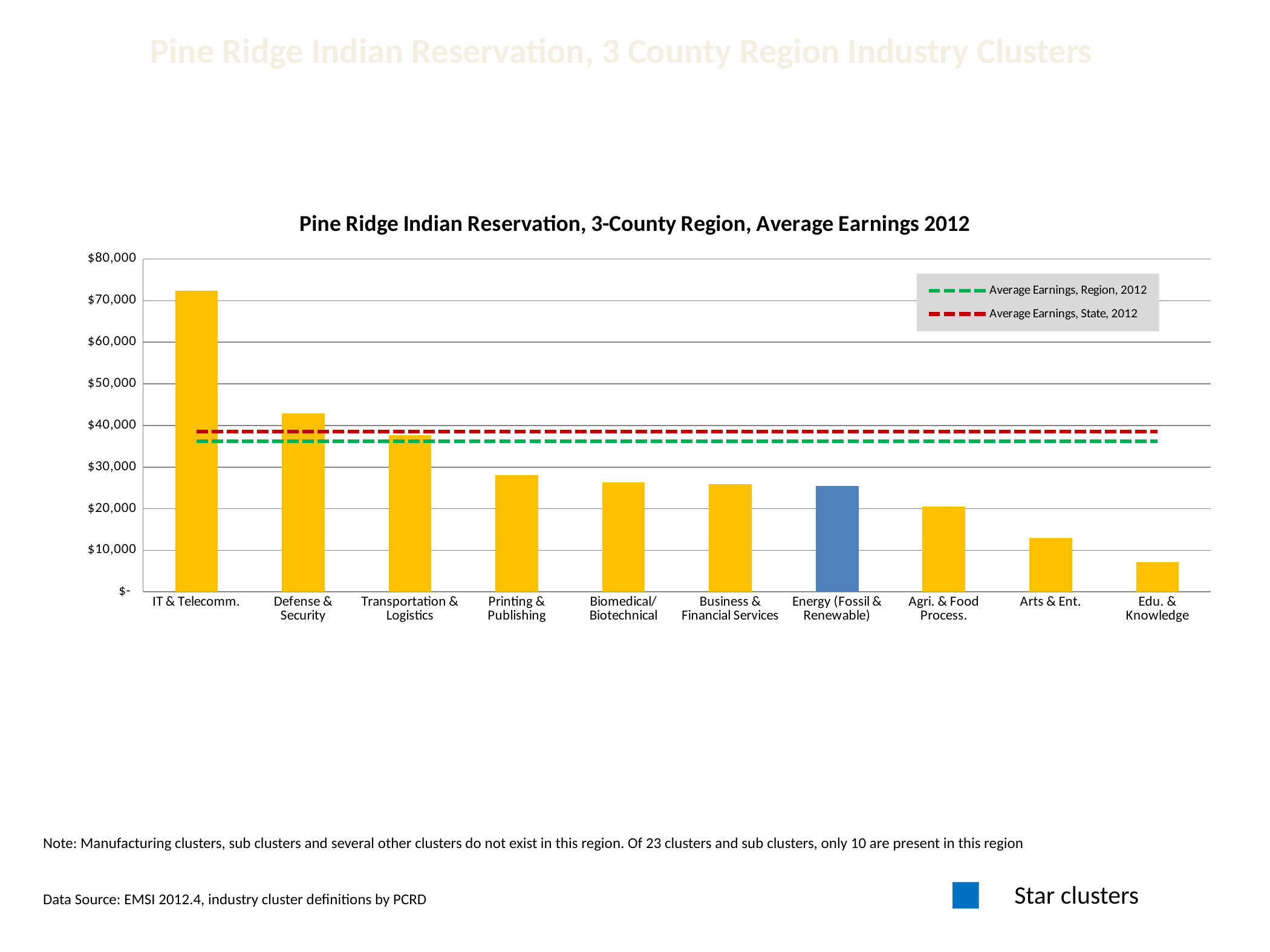
How many entries does the chart legend list? 2 Which industry cluster has the highest average earnings? IT & Telecomm. What kind of chart is shown on the slide? Bar chart Is the value for IT & Telecomm. greater or less than $70,000? greater Which industry cluster has the lowest average earnings? Edu. & Knowledge Which industry cluster is shown with a blue bar instead of a yellow one? Energy (Fossil & Renewable) Is the value for Transportation & Logistics greater or less than $40,000? less Is the value for Printing & Publishing greater or less than $30,000? less How many industry clusters are plotted along the x axis? 10 Which has higher average earnings, Defense & Security or Printing & Publishing? Defense & Security Do the bar values rise or fall moving from left to right along the x axis? Fall